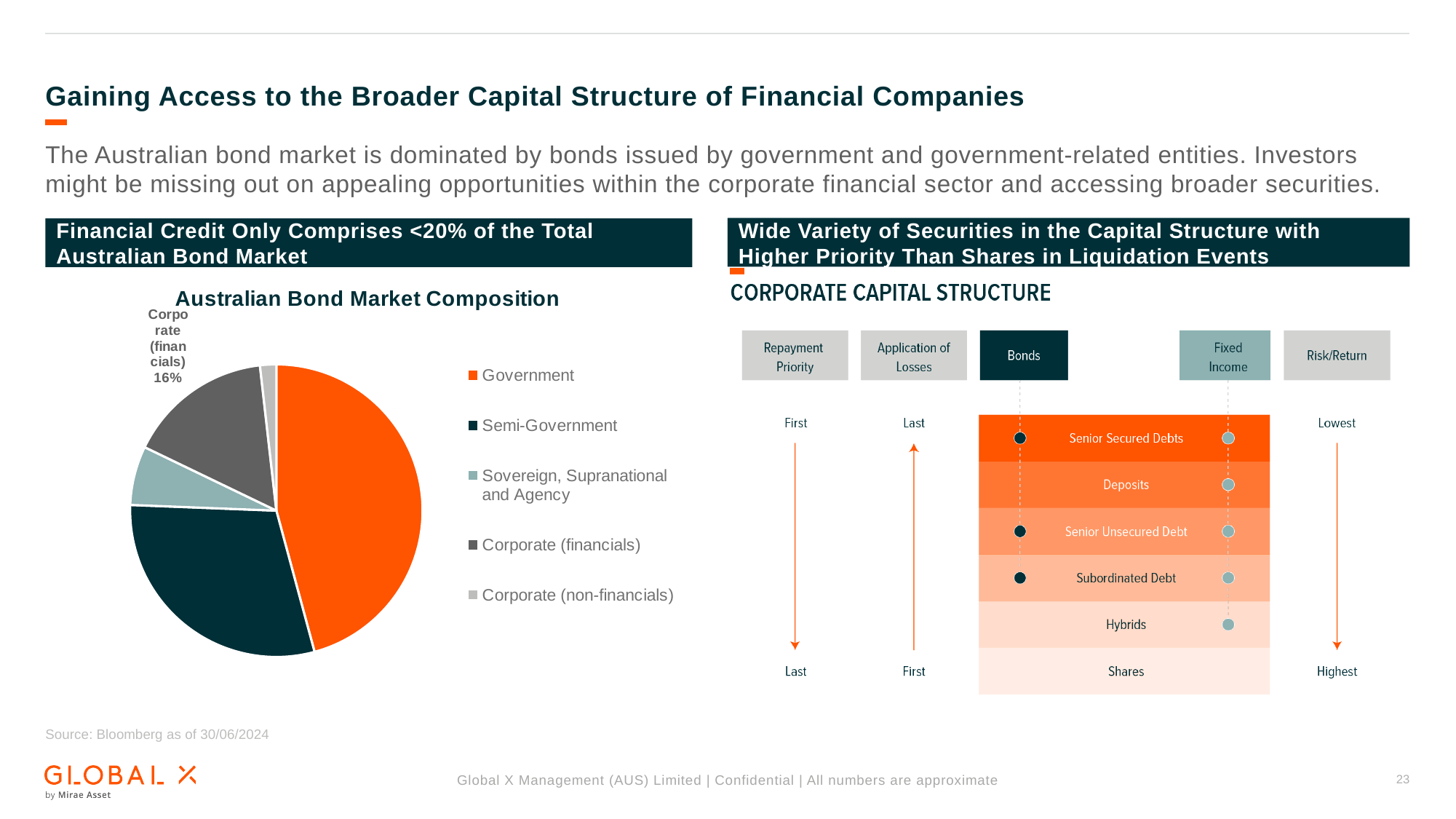
What is the title of the pie chart on the left of the slide? Australian Bond Market Composition How many slices does the Australian Bond Market Composition pie chart have? 5 How many entries does the legend of the Australian Bond Market Composition pie chart list? 5 What value is labelled on the Corporate (financials) slice of the Australian Bond Market Composition pie chart? 16% What kind of chart is the Australian Bond Market Composition chart? Pie chart What colour is the Government slice in the Australian Bond Market Composition pie chart? Orange In the Australian Bond Market Composition pie chart, which slice is larger: Corporate (financials) or Corporate (non-financials)? Corporate (financials) In the Australian Bond Market Composition pie chart, which slice is larger: Government or Semi-Government? Government Which category has the smallest slice in the Australian Bond Market Composition pie chart? Corporate (non-financials) In the Australian Bond Market Composition pie chart, which slice is larger: Semi-Government or Sovereign, Supranational and Agency? Semi-Government What share of the Australian Bond Market Composition pie is Corporate (financials)? 16% Which category has the largest slice in the Australian Bond Market Composition pie chart? Government